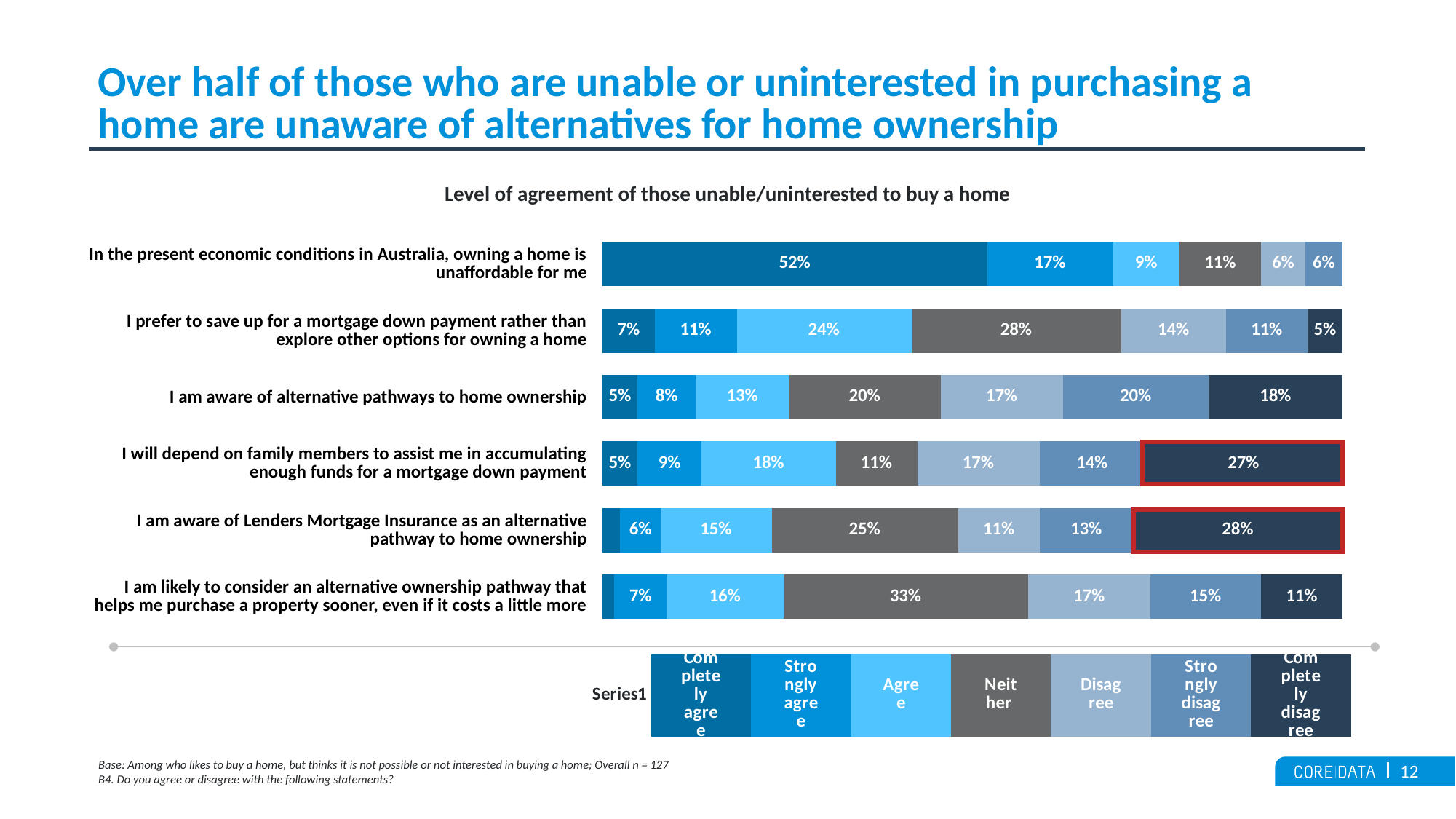
What percentage answered 'Neither' for the statement 'I prefer to save up for a mortgage down payment rather than explore other options for owning a home'? 28% Which is larger: the 'Agree' share for 'I prefer to save up for a mortgage down payment rather than explore other options for owning a home' or the 'Agree' share for 'I am aware of alternative pathways to home ownership'? I prefer to save up for a mortgage down payment rather than explore other options for owning a home What is the title of the chart? Level of agreement of those unable/uninterested to buy a home What percentage completely agree that in the present economic conditions in Australia, owning a home is unaffordable for them? 52% For the statement 'I am aware of alternative pathways to home ownership', what is the difference between the 'Neither' share and the 'Completely agree' share? 15% Which response category has the largest share for the statement 'I am likely to consider an alternative ownership pathway that helps me purchase a property sooner, even if it costs a little more'? Neither Which statement has the highest 'Completely agree' share? In the present economic conditions in Australia, owning a home is unaffordable for me What percentage completely disagree with 'I am aware of Lenders Mortgage Insurance as an alternative pathway to home ownership'? 28% What percentage completely disagree with 'I will depend on family members to assist me in accumulating enough funds for a mortgage down payment'? 27% What kind of chart is shown on the slide? Stacked bar chart How many response categories does the legend list? 7 How many statements (categories) are plotted in the chart? 6